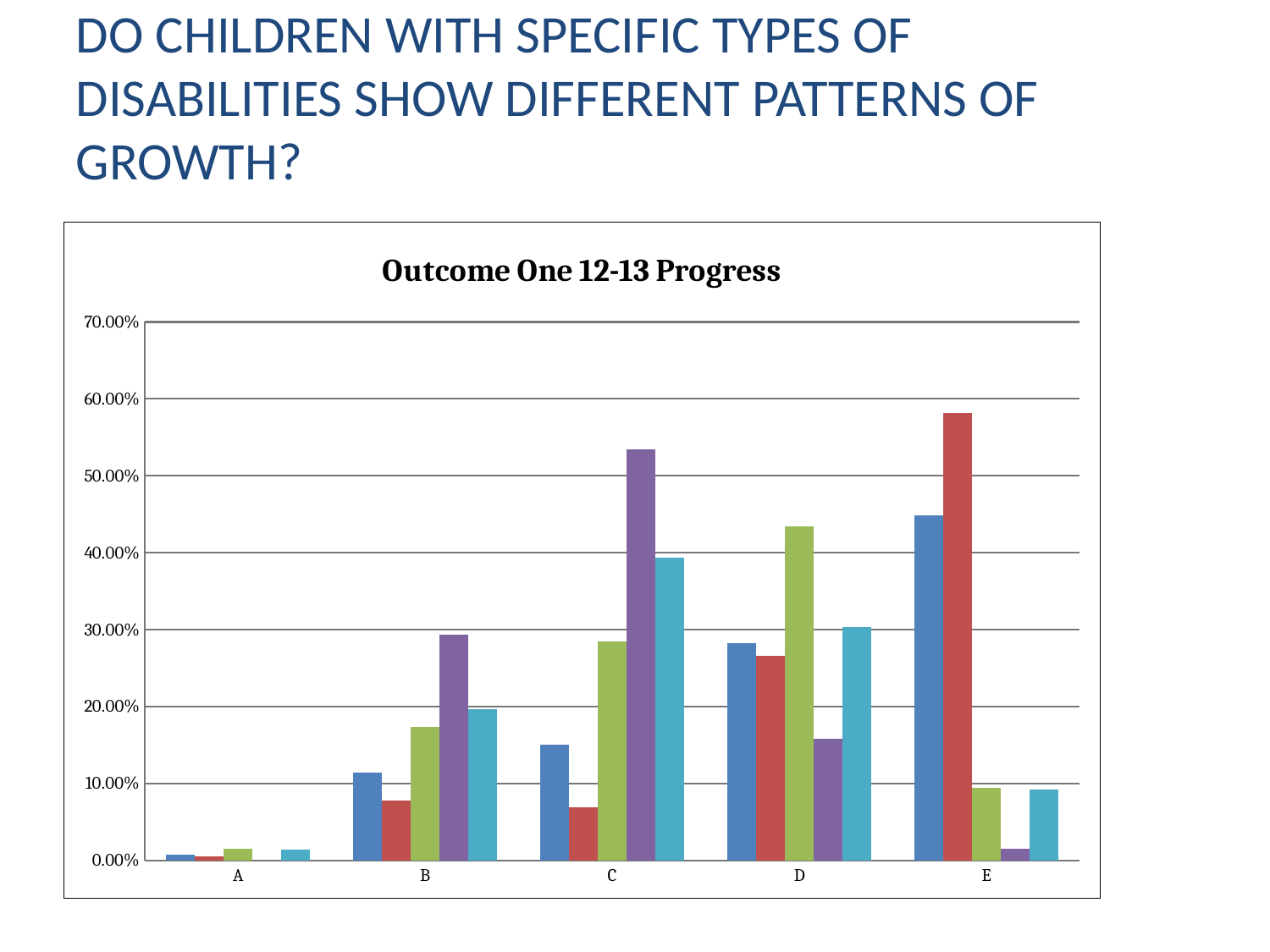
Is the value of the red bar for category B greater or less than 10.00%? less Is the value of the green bar for category D greater or less than 40.00%? greater Which category has the tallest red bar? E What is the title of the chart? Outcome One 12-13 Progress What kind of chart is shown on the slide? bar chart Is the value of the teal bar for category C greater or less than 30.00%? greater Which category has the lowest values across all its bars? A Which category has the tallest purple bar? C How many categories are shown on the x axis of the chart? 5 In category E, which is taller, the blue bar or the red bar? the red bar